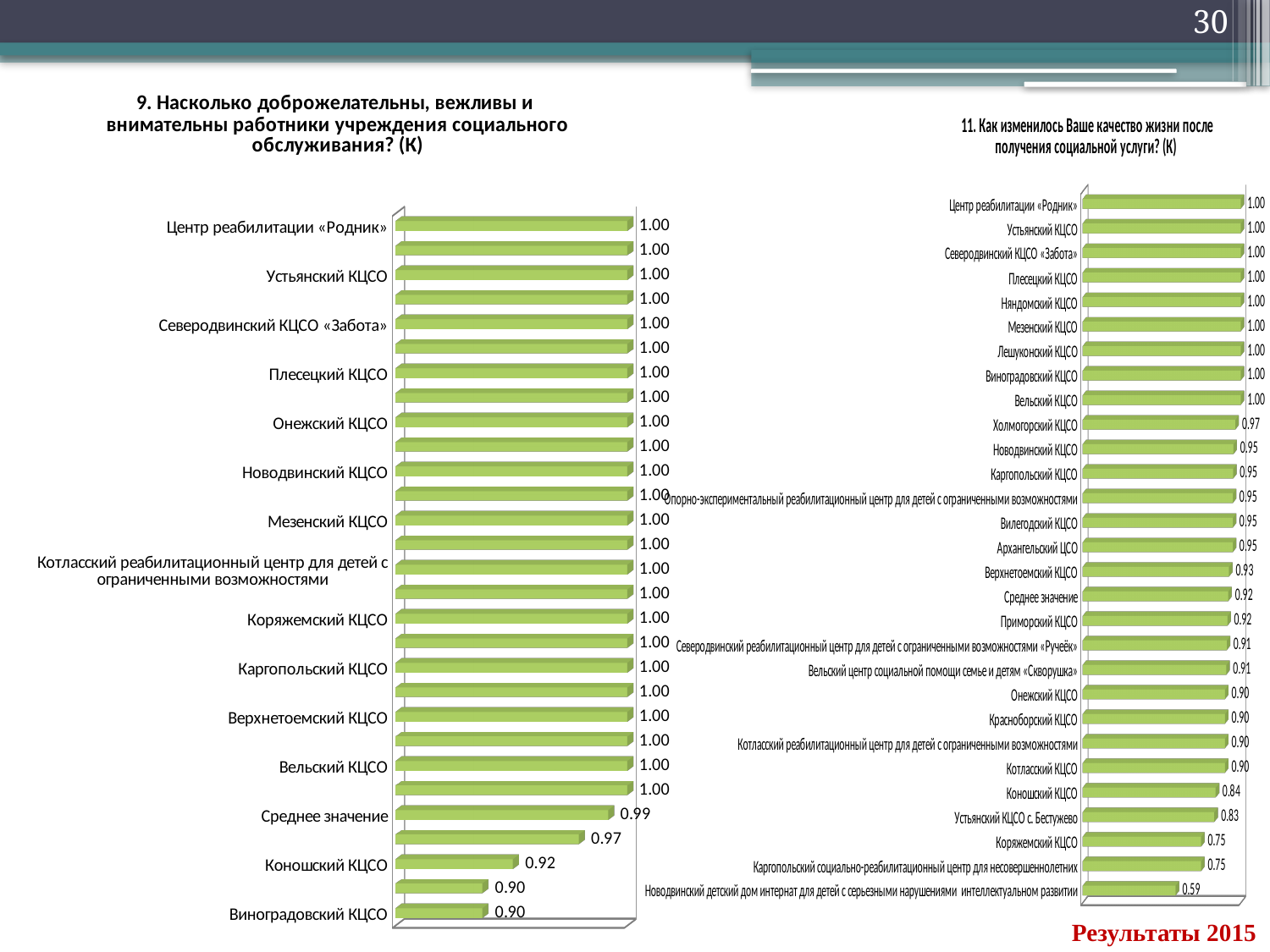
On the right chart (question 11), which is larger: the value for Верхнетоемский КЦСО or the value for Приморский КЦСО? Верхнетоемский КЦСО What is the title of the right chart? 11. Как изменилось Ваше качество жизни после получения социальной услуги? (К) On the right chart (question 11), which category has the lowest value? Новодвинский детский дом интернат для детей с серьезными нарушениями интеллектуальном развитии On the right chart (question 11), what is the value for Среднее значение? 0.92 On the left chart (question 9), what is the value for Коношский КЦСО? 0.92 What type of chart is the left chart (question 9)? Bar chart On the left chart (question 9), what is the value for Среднее значение? 0.99 On the right chart (question 11), what is the value for Холмогорский КЦСО? 0.97 On the left chart (question 9), what is the value for Виноградовский КЦСО? 0.90 On the right chart (question 11), what is the difference between the values for Коряжемский КЦСО and Коношский КЦСО? 0.09 On the right chart (question 11), what is the value for Коношский КЦСО? 0.84 On the left chart (question 9), what is the difference between the values for Среднее значение and Коношский КЦСО? 0.07